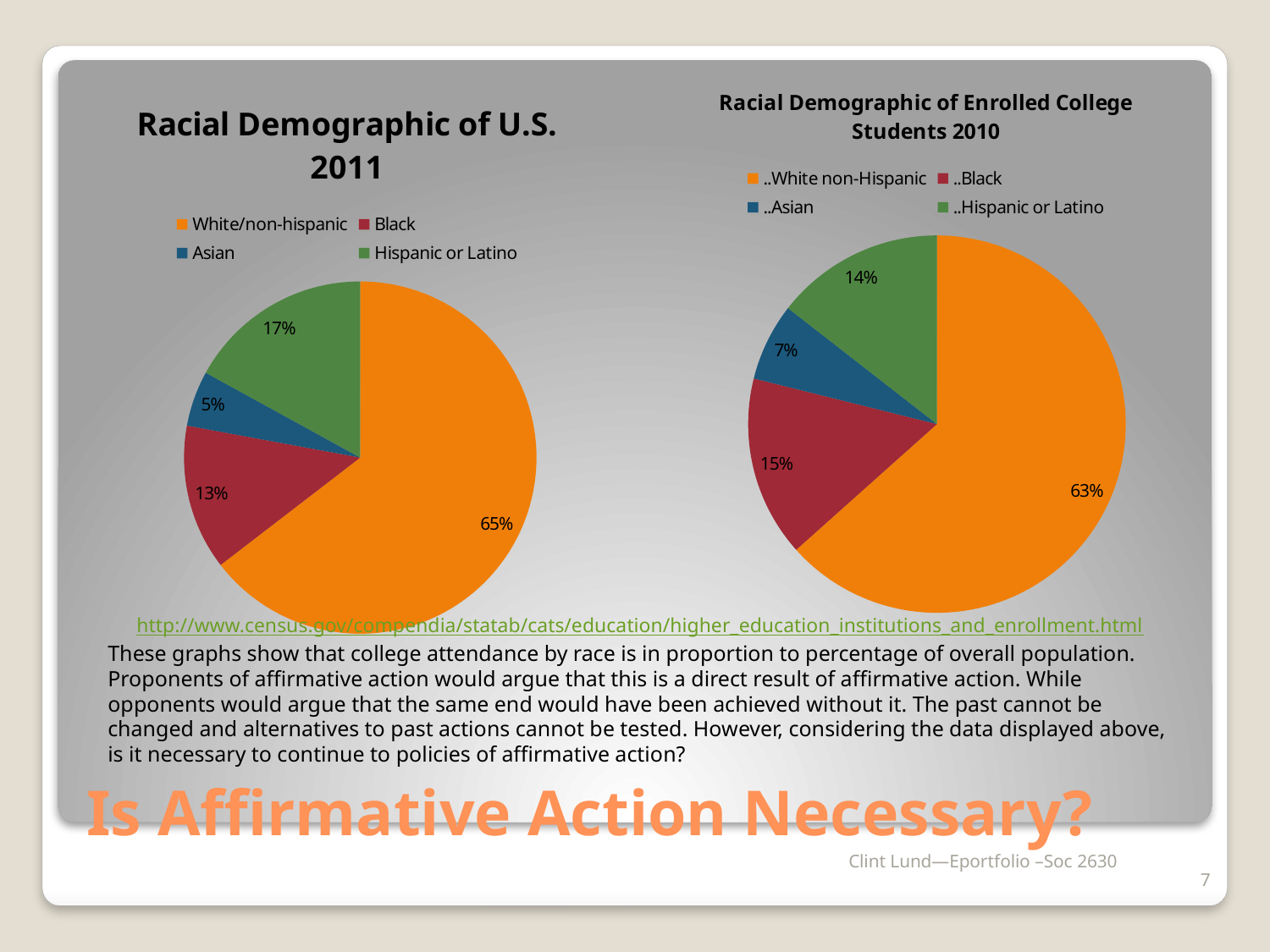
In the 'Racial Demographic of U.S. 2011' chart, which category has the smallest slice? Asian What type of chart is the 'Racial Demographic of Enrolled College Students 2010' chart? Pie chart Is the Hispanic or Latino share larger in the 'Racial Demographic of U.S. 2011' chart or in the 'Racial Demographic of Enrolled College Students 2010' chart? Racial Demographic of U.S. 2011 In the 'Racial Demographic of Enrolled College Students 2010' chart, which category has the largest slice? White non-Hispanic How many categories does the 'Racial Demographic of U.S. 2011' chart show? 4 In the 'Racial Demographic of Enrolled College Students 2010' chart, what is the difference between the White non-Hispanic and Hispanic or Latino shares? 49% In the 'Racial Demographic of U.S. 2011' chart, what share does the Hispanic or Latino slice have? 17% In the 'Racial Demographic of Enrolled College Students 2010' chart, what share does the Asian slice have? 7% In the 'Racial Demographic of U.S. 2011' chart, what colour is the Black slice? Red In the 'Racial Demographic of U.S. 2011' chart, what is the difference between the Black and Asian shares? 8% In the 'Racial Demographic of Enrolled College Students 2010' chart, what share does the Black slice have? 15% In the 'Racial Demographic of U.S. 2011' chart, what share does the White/non-hispanic slice have? 65%